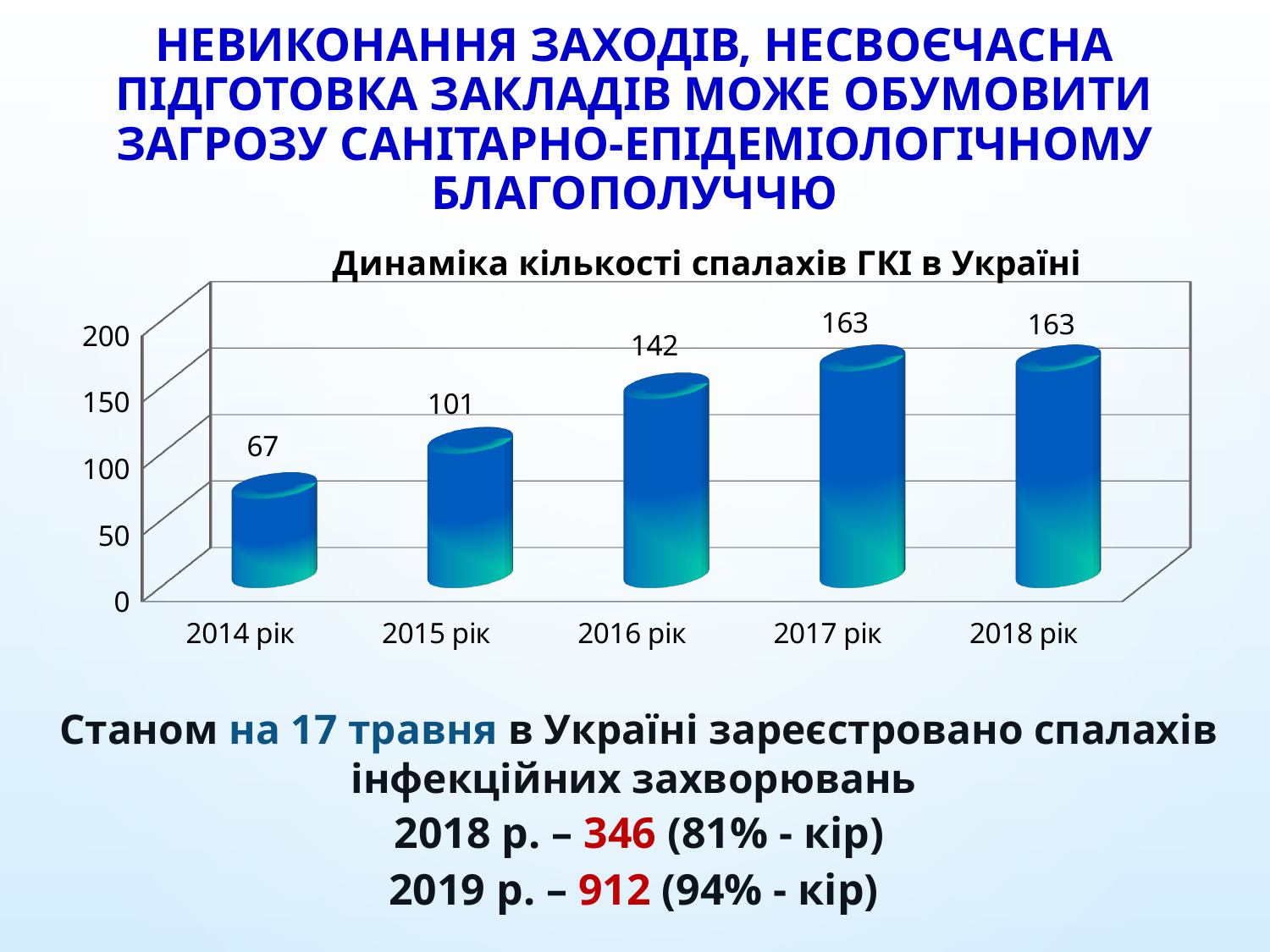
Which year has the lowest value? 2014 рік What is the value for 2015 рік? 101 What is the value for 2017 рік? 163 What is the value for 2016 рік? 142 How many years are shown on the x axis? 5 What is the title of the chart? Динаміка кількості спалахів ГКІ в Україні What is the difference between the values for 2016 рік and 2015 рік? 41 Which is larger, the value for 2016 рік or the value for 2015 рік? 2016 рік What kind of chart is shown on the slide? bar chart What is the difference between the values for 2018 рік and 2014 рік? 96 Is the value for 2014 рік greater or less than 100? less What is the value for 2014 рік? 67